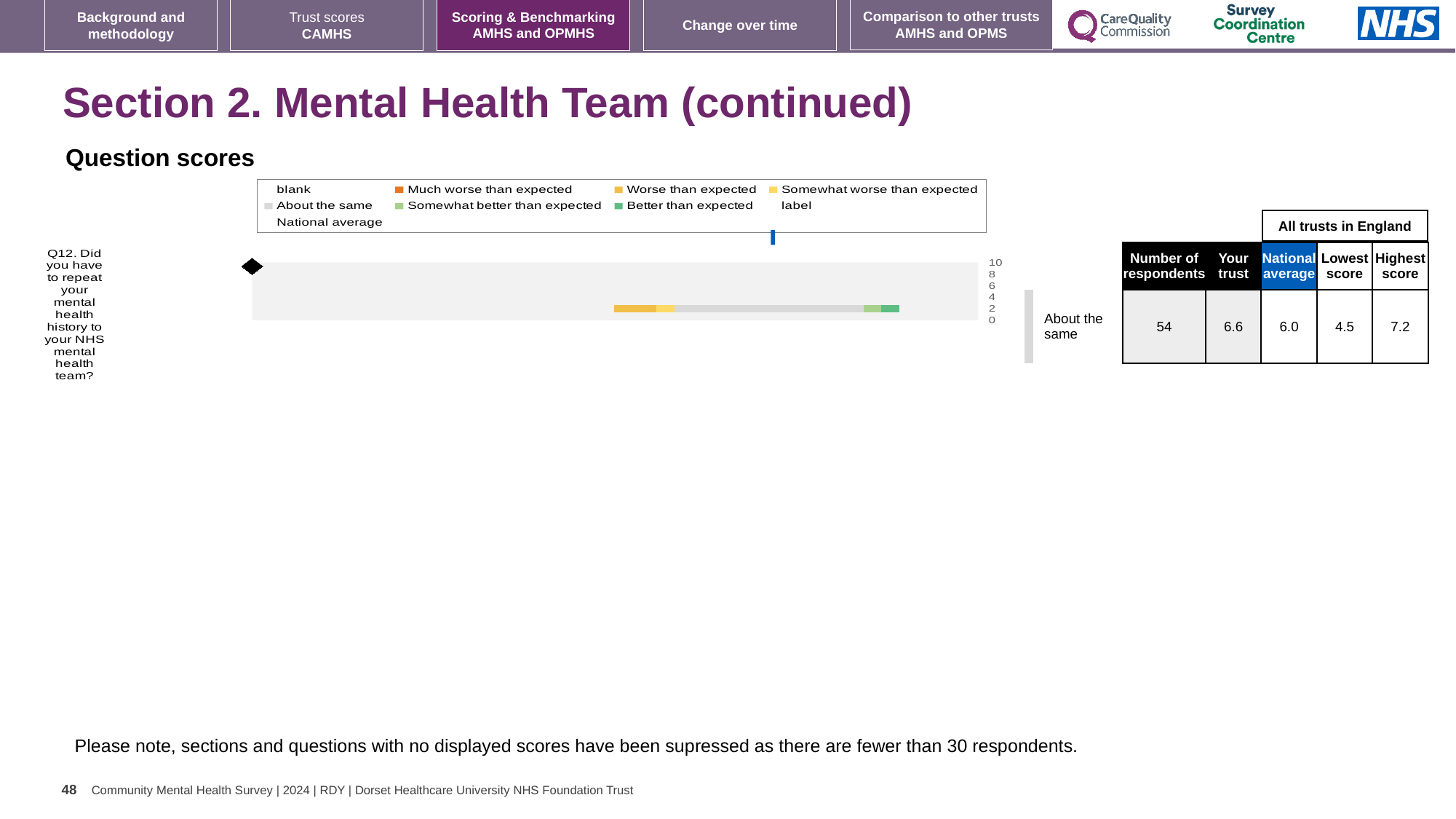
What is the difference between the 'Your trust' score and the national average for Q12? 0.6 What is the national average score for Q12? 6.0 What category label is shown next to the Q12 bar in the Question scores chart? About the same What is the difference between the highest score and the lowest score for Q12? 2.7 What kind of chart is used to show the Q12 question score? bar chart How many questions are plotted in the Question scores chart? 1 What is the lowest score among all trusts in England for Q12? 4.5 What is the highest score among all trusts in England for Q12? 7.2 Which is larger for Q12, the 'Your trust' score or the national average? Your trust How many respondents answered Q12? 54 What is the 'Your trust' score for Q12? 6.6 Which question is shown in the Question scores chart? Q12. Did you have to repeat your mental health history to your NHS mental health team?